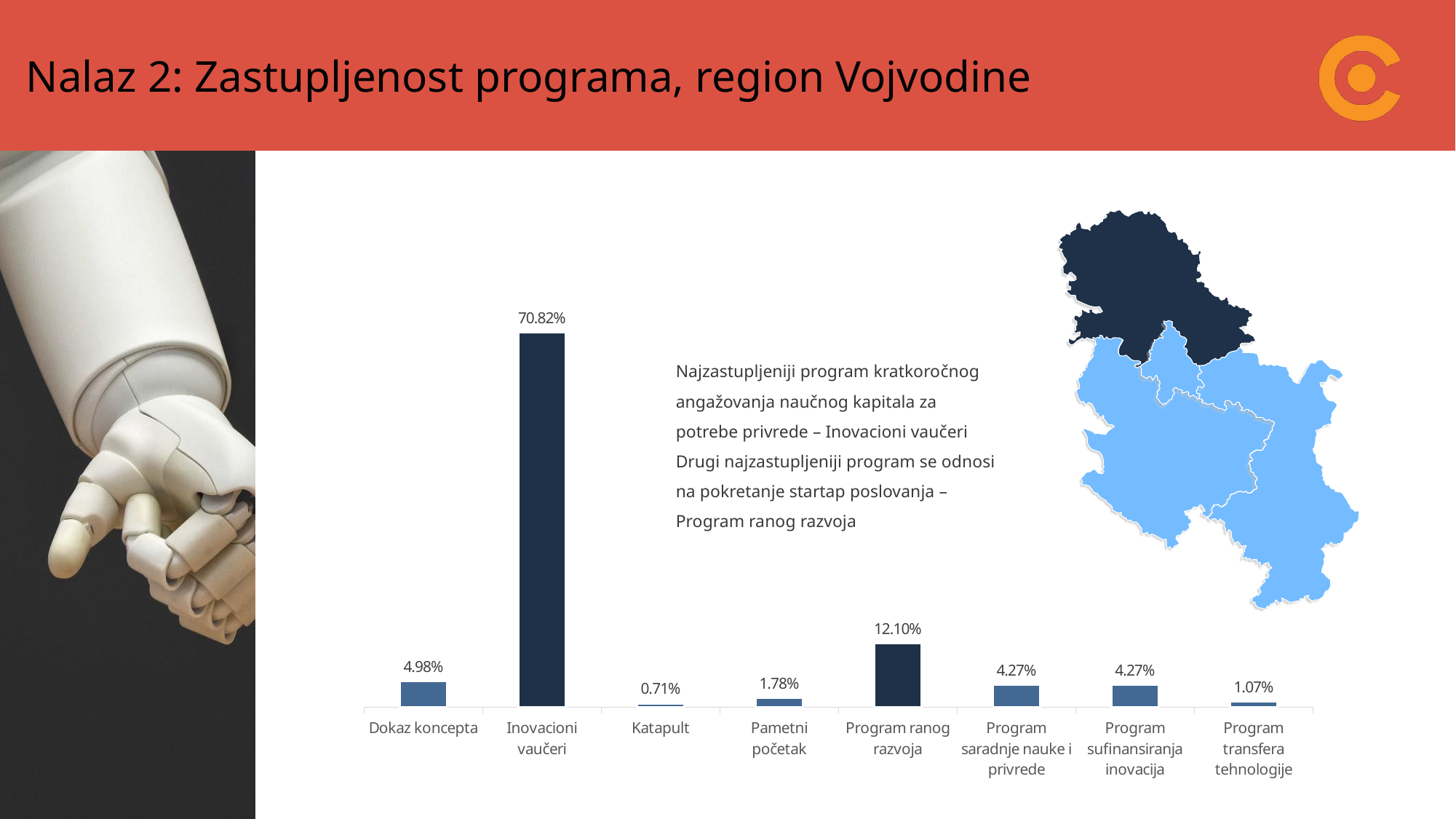
Which category has the highest value? Inovacioni vaučeri What is the value for Inovacioni vaučeri? 70.82% What kind of chart is shown on the slide? Bar chart Which is larger, the value for Dokaz koncepta or the value for Pametni početak? Dokaz koncepta What is the value for Dokaz koncepta? 4.98% How many categories are shown on the x axis? 8 Which category has the lowest value? Katapult What is the difference between the values for Inovacioni vaučeri and Program ranog razvoja? 58.72% What is the value for Program transfera tehnologije? 1.07% What is the value for Katapult? 0.71% What is the value for Program ranog razvoja? 12.10% Which two categories share the same value of 4.27%? Program saradnje nauke i privrede and Program sufinansiranja inovacija